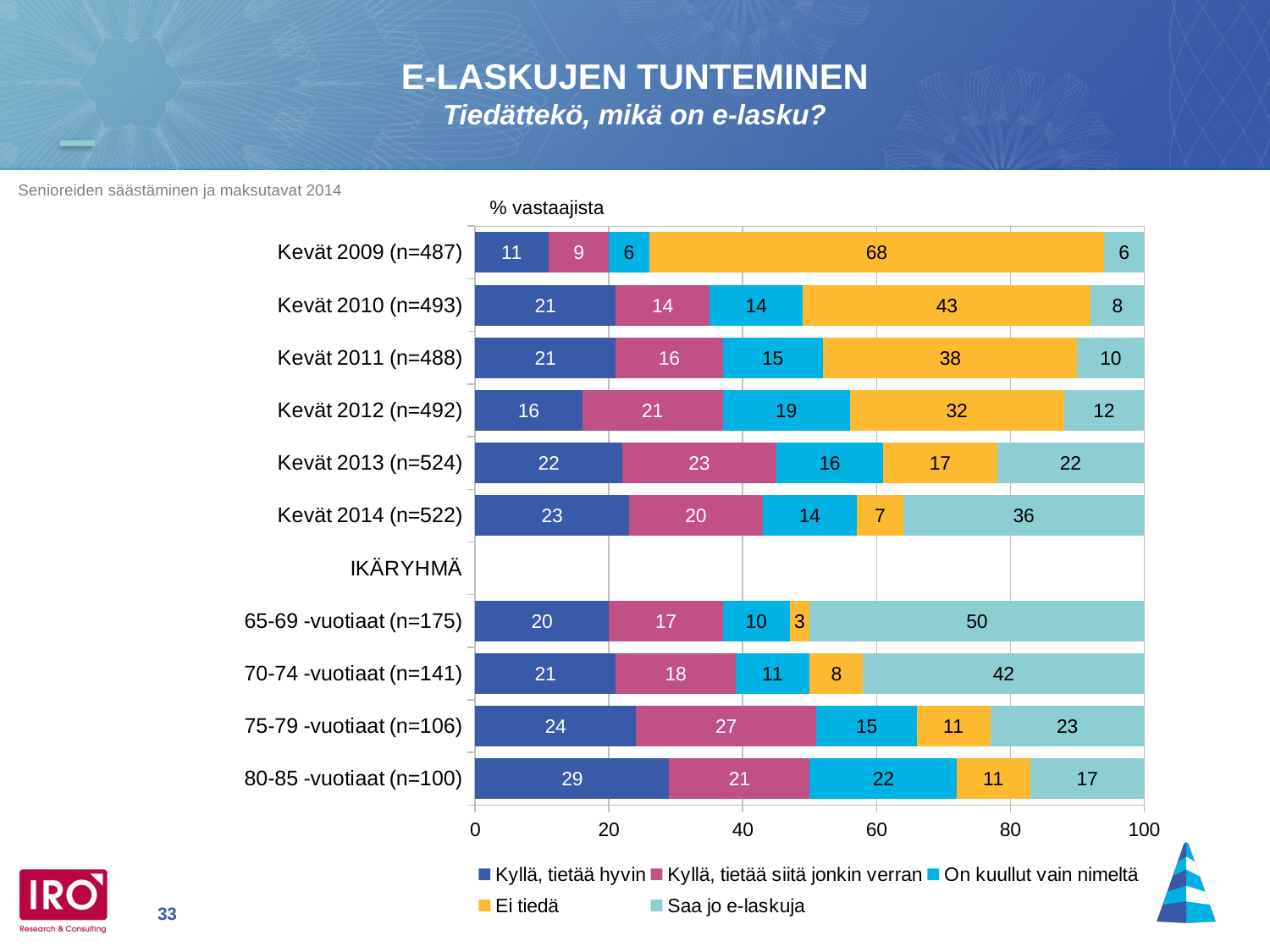
Which has the larger "Saa jo e-laskuja" value: 65-69 -vuotiaat (n=175) or 80-85 -vuotiaat (n=100)? 65-69 -vuotiaat (n=175) Which category has the highest value for "Ei tiedä"? Kevät 2009 (n=487) Does the "Ei tiedä" value rise or fall from Kevät 2009 to Kevät 2014? Fall Which category has the lowest value for "Ei tiedä"? 65-69 -vuotiaat (n=175) What is the total of the stacked bar for Kevät 2013 (n=524)? 100 What kind of chart is shown on the slide? Stacked bar chart How many series does the legend list? 5 What is the value of "Kyllä, tietää hyvin" for 80-85 -vuotiaat (n=100)? 29 What label is shown above the chart as the axis title? % vastaajista What is the value of "Ei tiedä" for Kevät 2009 (n=487)? 68 What is the value of "Saa jo e-laskuja" for Kevät 2014 (n=522)? 36 What is the difference between the "Ei tiedä" values for Kevät 2009 (n=487) and Kevät 2014 (n=522)? 61